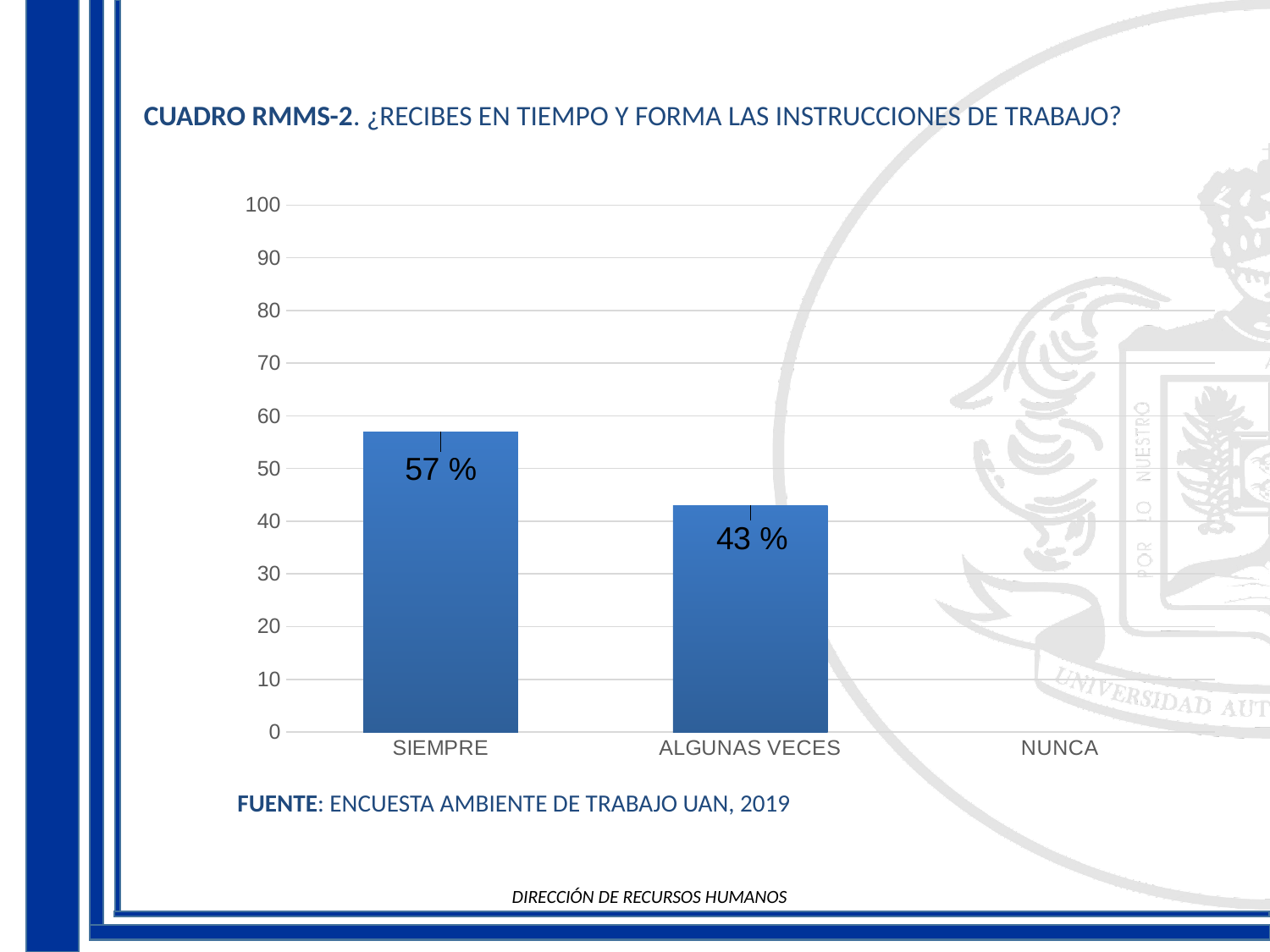
What is the value for SIEMPRE? 57 % Is the value for ALGUNAS VECES greater or less than 50? less How many categories are shown on the x axis? 3 What source is cited below the chart? ENCUESTA AMBIENTE DE TRABAJO UAN, 2019 Do the values rise or fall from SIEMPRE to ALGUNAS VECES? Fall Is the value for SIEMPRE greater or less than 50? greater What kind of chart is shown on the slide? Bar chart What is the difference between the values for SIEMPRE and ALGUNAS VECES? 14 % Which is larger, the value for SIEMPRE or the value for ALGUNAS VECES? SIEMPRE Which category has the highest value? SIEMPRE What is the value for ALGUNAS VECES? 43 % What is the maximum value shown on the y axis? 100